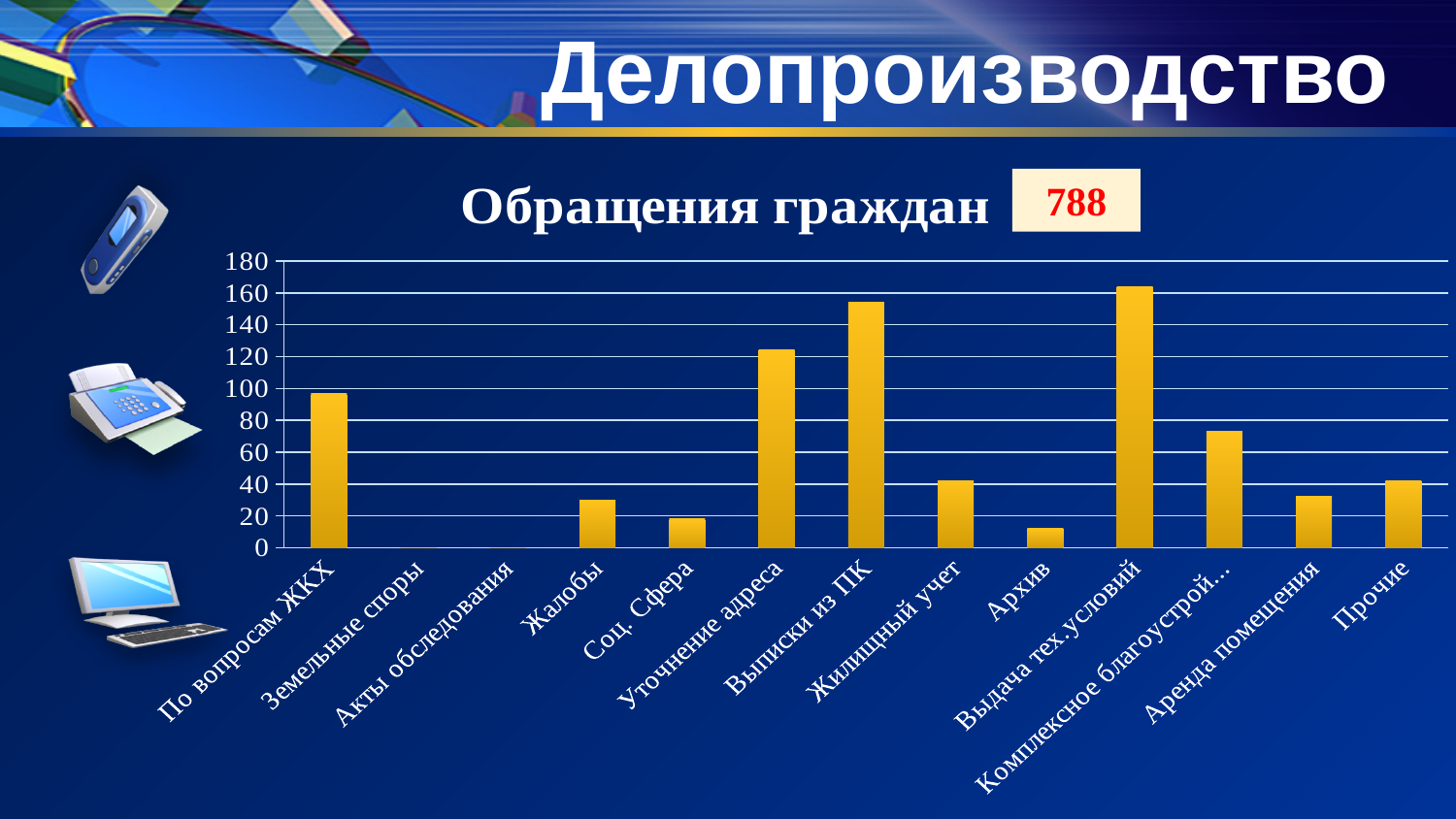
Which is larger, the value for Аренда помещения or the value for Прочие? Прочие What number is shown in the box next to the chart title? 788 Which is larger, the value for Уточнение адреса or the value for Выписки из ПК? Выписки из ПК How many categories are shown on the x axis of the chart? 13 What is the title of the chart? Обращения граждан What kind of chart is shown on the slide? Bar chart Is the value for Уточнение адреса greater or less than 100? greater Is the value for По вопросам ЖКХ greater or less than 80? greater Is the value for Архив greater or less than 20? less Which category has the highest value in the chart? Выдача тех.условий